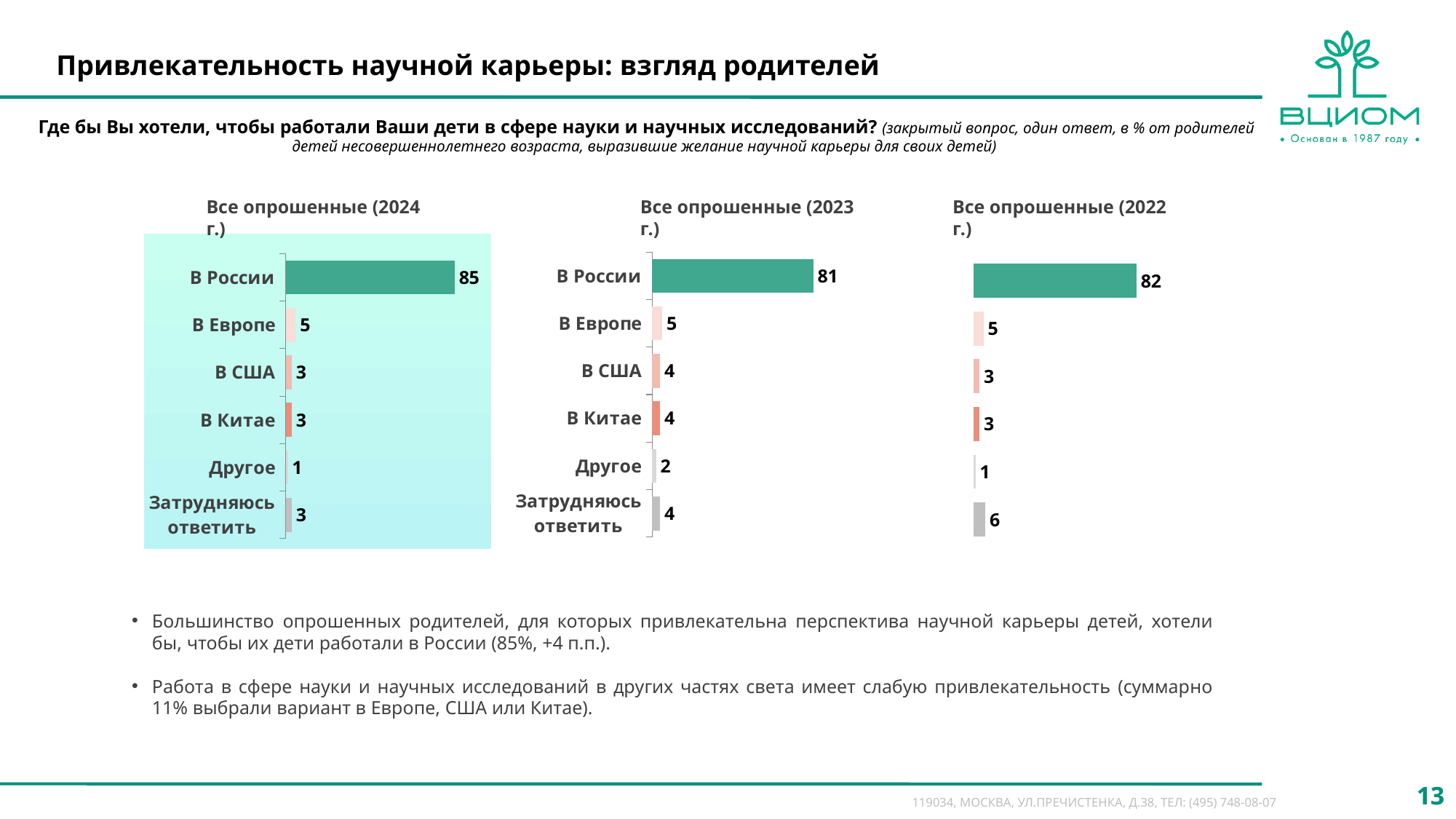
In the chart 'Все опрошенные (2024 г.)', what is the value for 'Затрудняюсь ответить'? 3 In the chart 'Все опрошенные (2023 г.)', what is the value for 'В Китае'? 4 In the chart 'Все опрошенные (2024 г.)', what is the difference between the values for 'В России' and 'В Европе'? 80 In the chart 'Все опрошенные (2023 г.)', which is larger: the value for 'В Европе' or the value for 'В США'? В Европе In the chart 'Все опрошенные (2024 г.)', which category has the highest value? В России How many categories are shown in the chart 'Все опрошенные (2024 г.)'? 6 In the chart 'Все опрошенные (2023 г.)', which category has the lowest value? Другое How many charts are shown on the slide? 3 In the chart 'Все опрошенные (2023 г.)', what is the value for 'Другое'? 2 In the chart 'Все опрошенные (2024 г.)', what is the value for 'В России'? 85 What type of chart is 'Все опрошенные (2023 г.)'? Bar chart In the chart 'Все опрошенные (2022 г.)', what is the largest value shown? 82